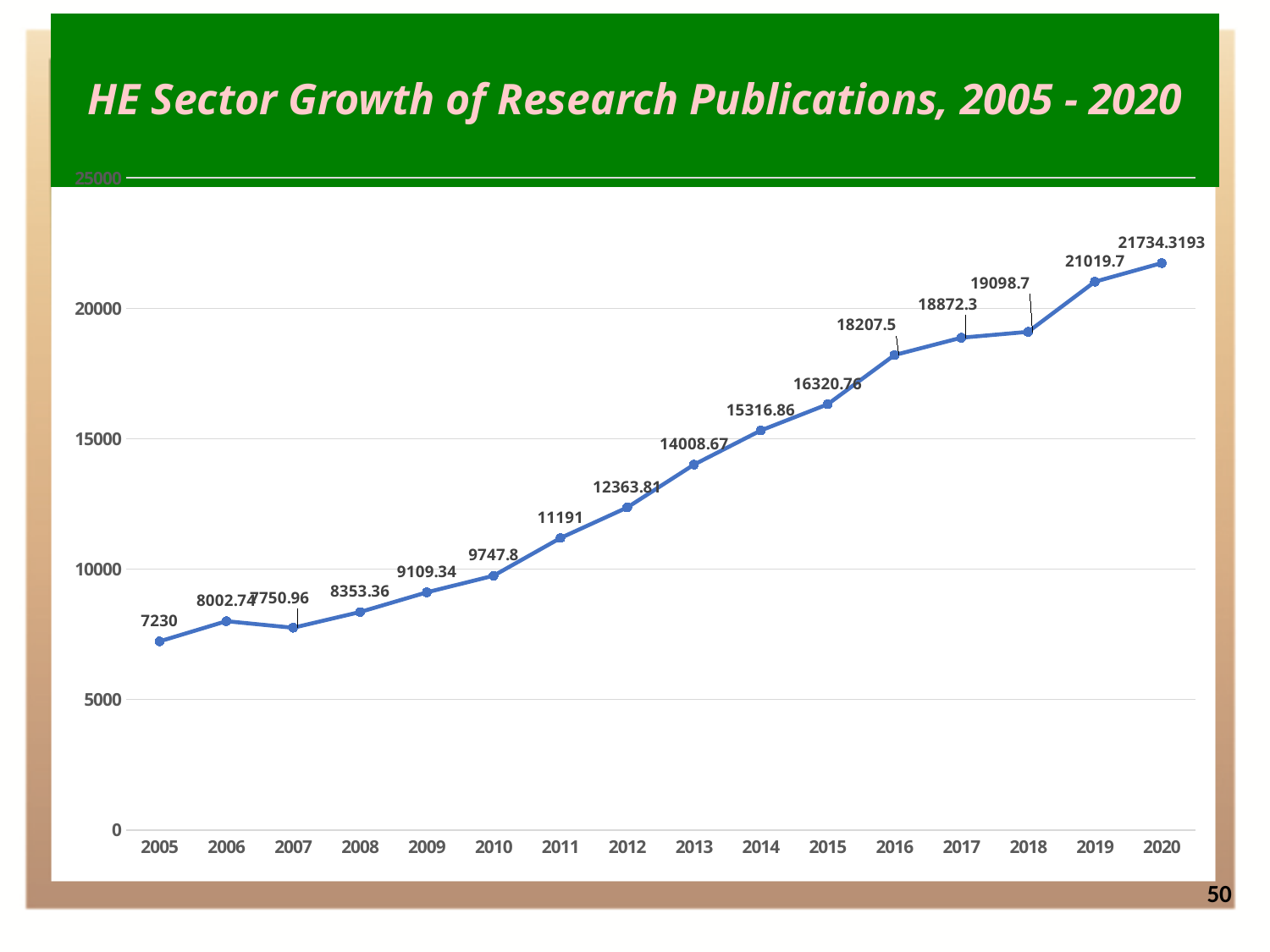
Which is larger, the value for 2006 or the value for 2007? 2006 Is the value for 2013 greater or less than 15000? less What is the value for 2016? 18207.5 What is the difference between the values for 2019 and 2018? 1921 What is the value for 2011? 11191 Which year has the lowest value? 2005 Which year has the highest value? 2020 What is the value for 2020? 21734.3193 What is the value for 2005? 7230 How many years are plotted on the chart? 16 What kind of chart is shown on the slide? line chart What is the difference between the values for 2011 and 2005? 3961